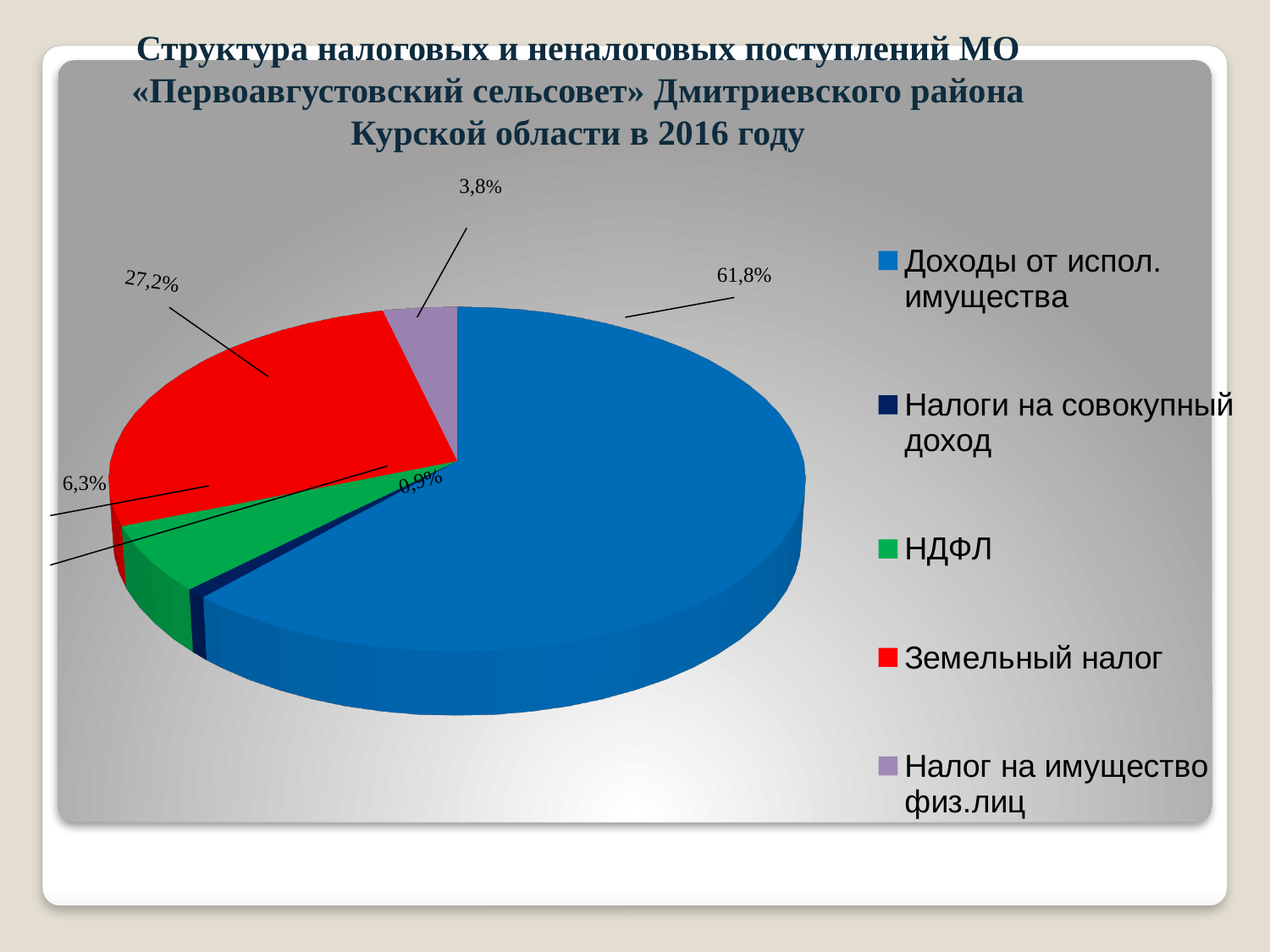
What is the difference between the shares of «Доходы от испол. имущества» and «Земельный налог»? 34,6% Which is larger: the share of «НДФЛ» or the share of «Налог на имущество физ.лиц»? НДФЛ Which category has the largest share of the pie? Доходы от испол. имущества What share of the pie does «Налог на имущество физ.лиц» have? 3,8% What share of the pie does «Доходы от испол. имущества» have? 61,8% What colour is the slice for «Земельный налог»? red What share of the pie does «НДФЛ» have? 6,3% What kind of chart is shown on the slide? pie chart What share of the pie does «Налоги на совокупный доход» have? 0,9% Which category has the smallest share of the pie? Налоги на совокупный доход What share of the pie does «Земельный налог» have? 27,2% How many categories does the legend list? 5